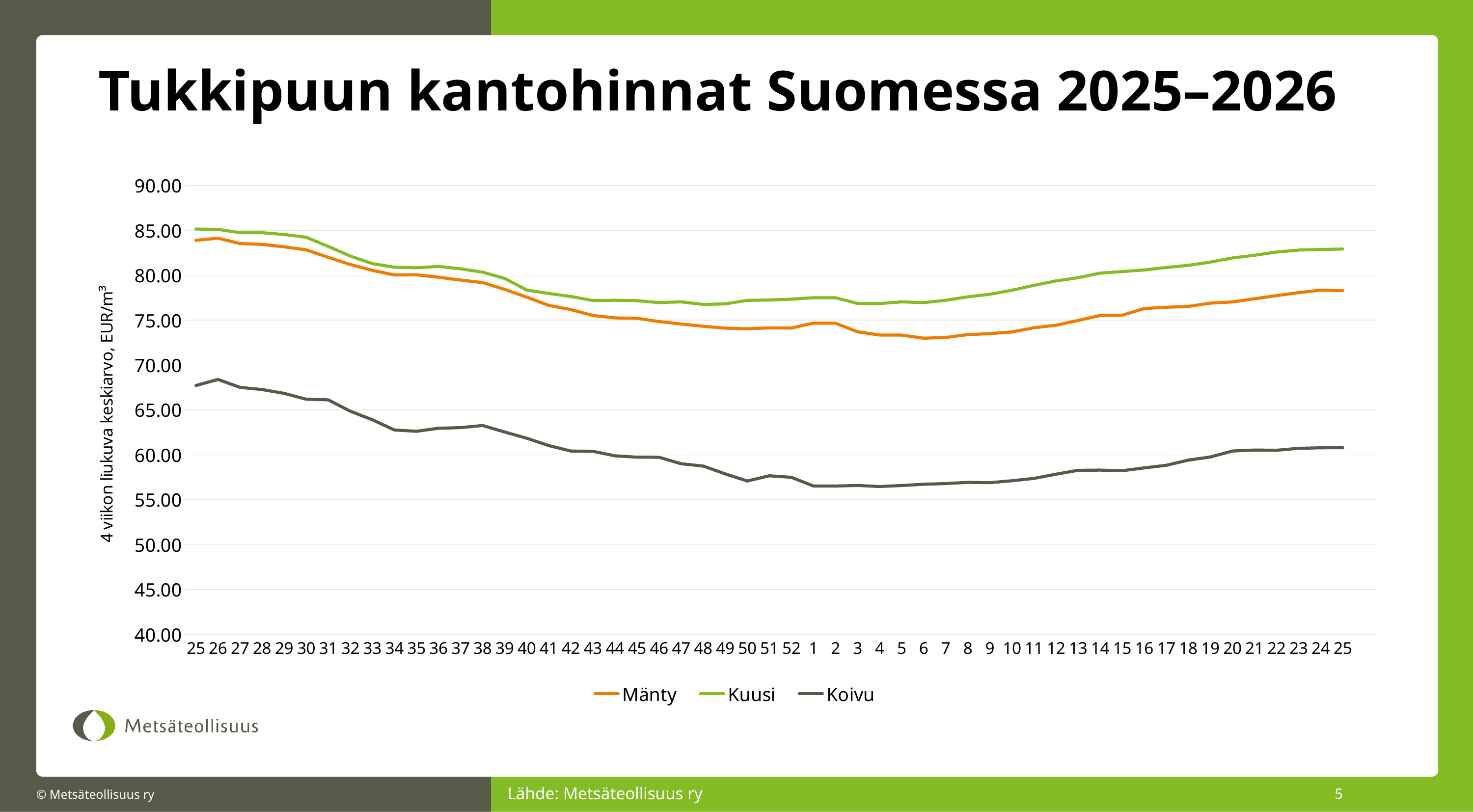
Which series has the highest values across the whole chart? Kuusi Is the value for Mänty at week 6 greater or less than 75.00? less At week 40, which is larger, the value for Kuusi or the value for Mänty? Kuusi Is the value for Koivu at week 25 (the first point) greater or less than 65.00? greater Is the value for Kuusi at week 25 (the last point) greater or less than 80.00? greater Does the Koivu line rise or fall from week 25 to week 4? Fall What is the title of the chart? Tukkipuun kantohinnat Suomessa 2025–2026 Which series has the lowest values across the whole chart? Koivu What is the label on the vertical axis? 4 viikon liukuva keskiarvo, EUR/m³ What kind of chart is shown on the slide? Line chart How many series does the legend list? 3